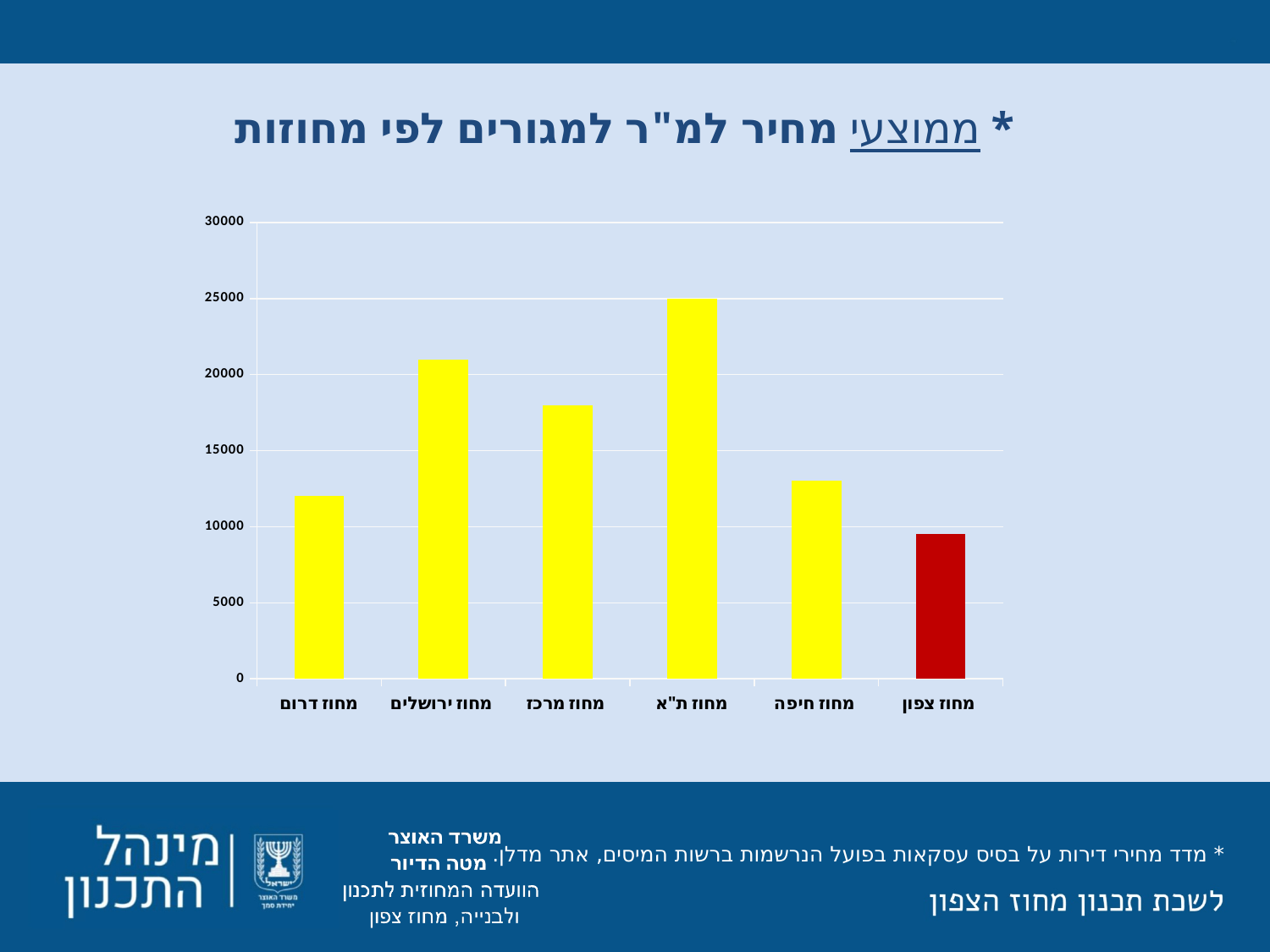
Is the value for מחוז ירושלים greater or less than 20000? greater Which district's bar is coloured red instead of yellow? מחוז צפון What kind of chart is shown on the slide? bar chart What is the highest value shown on the chart's vertical axis? 30000 Which has a higher value in the chart, מחוז חיפה or מחוז דרום? מחוז חיפה Is the value for מחוז דרום greater or less than 15000? less Which has a higher value in the chart, מחוז ירושלים or מחוז מרכז? מחוז ירושלים Is the value for מחוז מרכז greater or less than 15000? greater How many districts (categories) are shown on the x axis of the chart? 6 Which district has the lowest average price per square metre in the chart? מחוז צפון Which district has the highest average price per square metre in the chart? מחוז ת"א